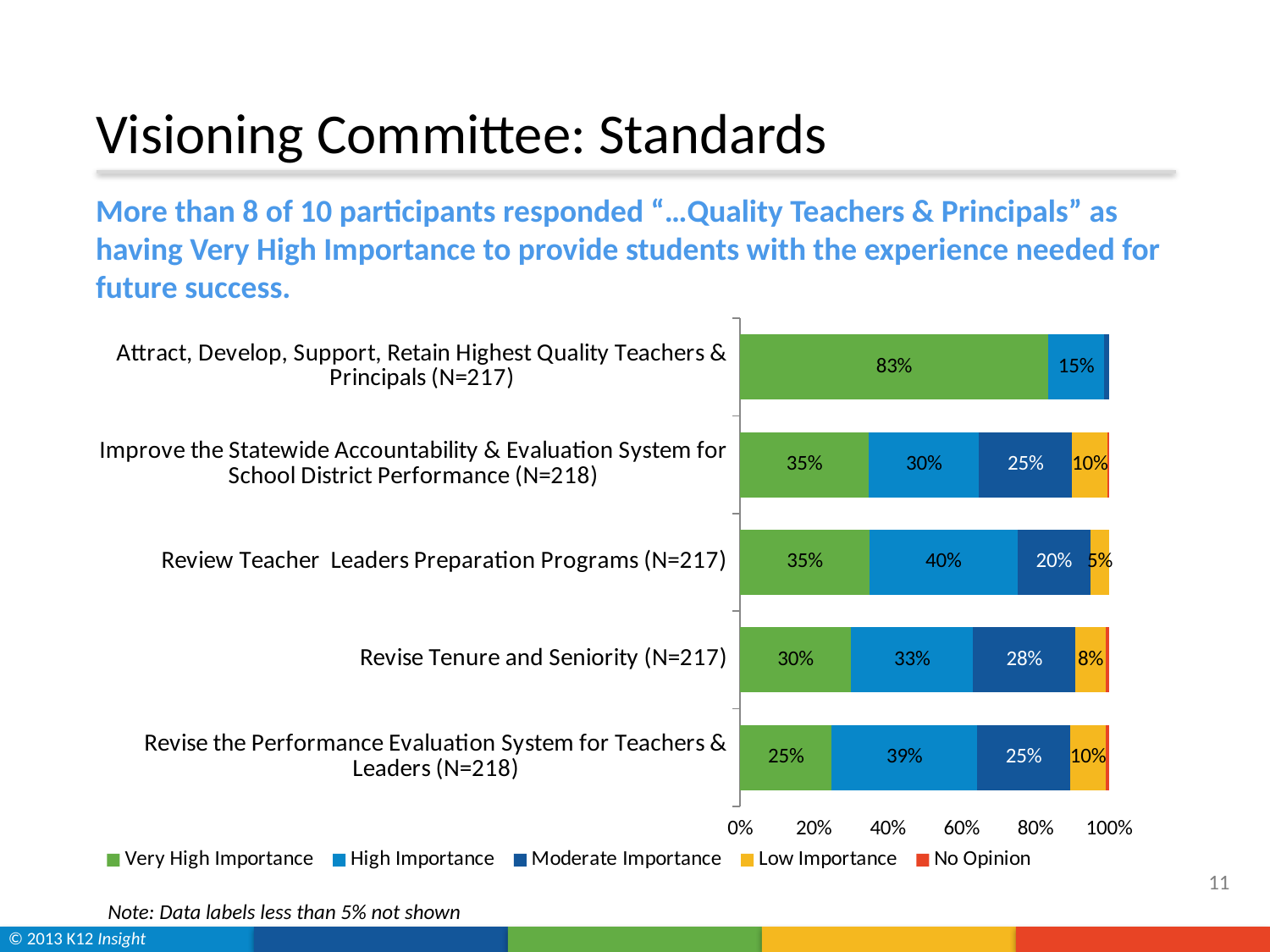
What is the Low Importance value for "Revise the Performance Evaluation System for Teachers & Leaders (N=218)"? 10% Which category has the highest Very High Importance value? Attract, Develop, Support, Retain Highest Quality Teachers & Principals (N=217) How many series does the legend list? 5 What is the Very High Importance value for "Attract, Develop, Support, Retain Highest Quality Teachers & Principals (N=217)"? 83% Which is larger: the High Importance value for "Revise the Performance Evaluation System for Teachers & Leaders (N=218)" or for "Improve the Statewide Accountability & Evaluation System for School District Performance (N=218)"? Revise the Performance Evaluation System for Teachers & Leaders (N=218) What is the difference between the Very High Importance values for "Attract, Develop, Support, Retain Highest Quality Teachers & Principals (N=217)" and "Revise Tenure and Seniority (N=217)"? 53% How many categories are plotted on the chart? 5 Which category has the lowest Very High Importance value? Revise the Performance Evaluation System for Teachers & Leaders (N=218) What is the High Importance value for "Review Teacher Leaders Preparation Programs (N=217)"? 40% Which series is shown in green in the legend? Very High Importance What type of chart is shown on the slide? Stacked bar chart What is the Moderate Importance value for "Revise Tenure and Seniority (N=217)"? 28%